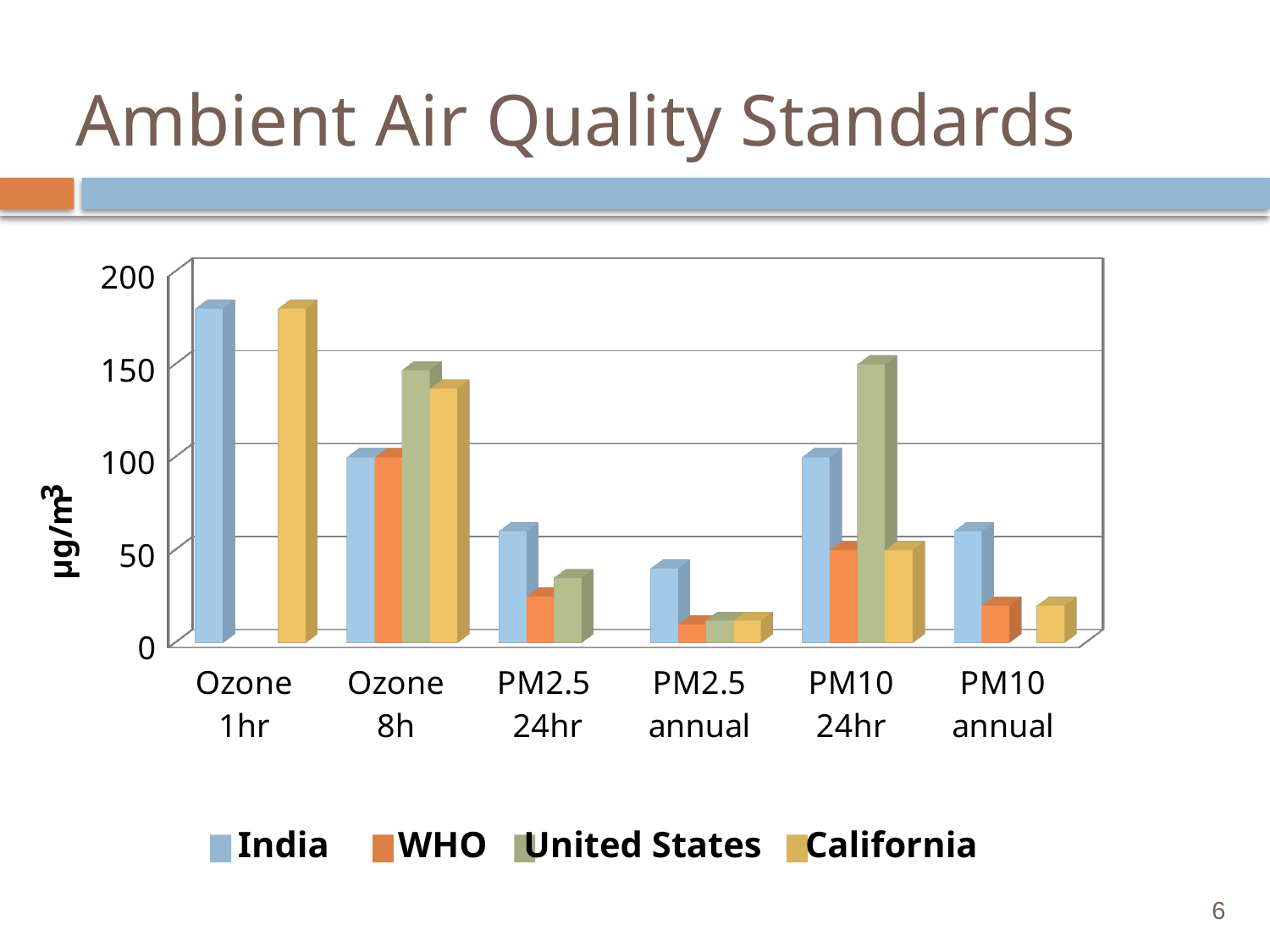
What is the label on the vertical axis? µg/m³ Is the value for India in the PM2.5 annual category greater or less than 50? less What kind of chart is shown on the slide? bar chart Is the value for India in the Ozone 1hr category greater or less than 150? greater In the PM10 24hr category, which is larger: the United States value or the India value? United States Is the value for WHO in the PM2.5 24hr category greater or less than 50? less Which category has the highest value for India? Ozone 1hr In the PM10 24hr category, which series has the highest value? United States How many categories are shown on the x axis? 6 How many series does the legend list? 4 In the Ozone 8h category, which is larger: the United States value or the WHO value? United States